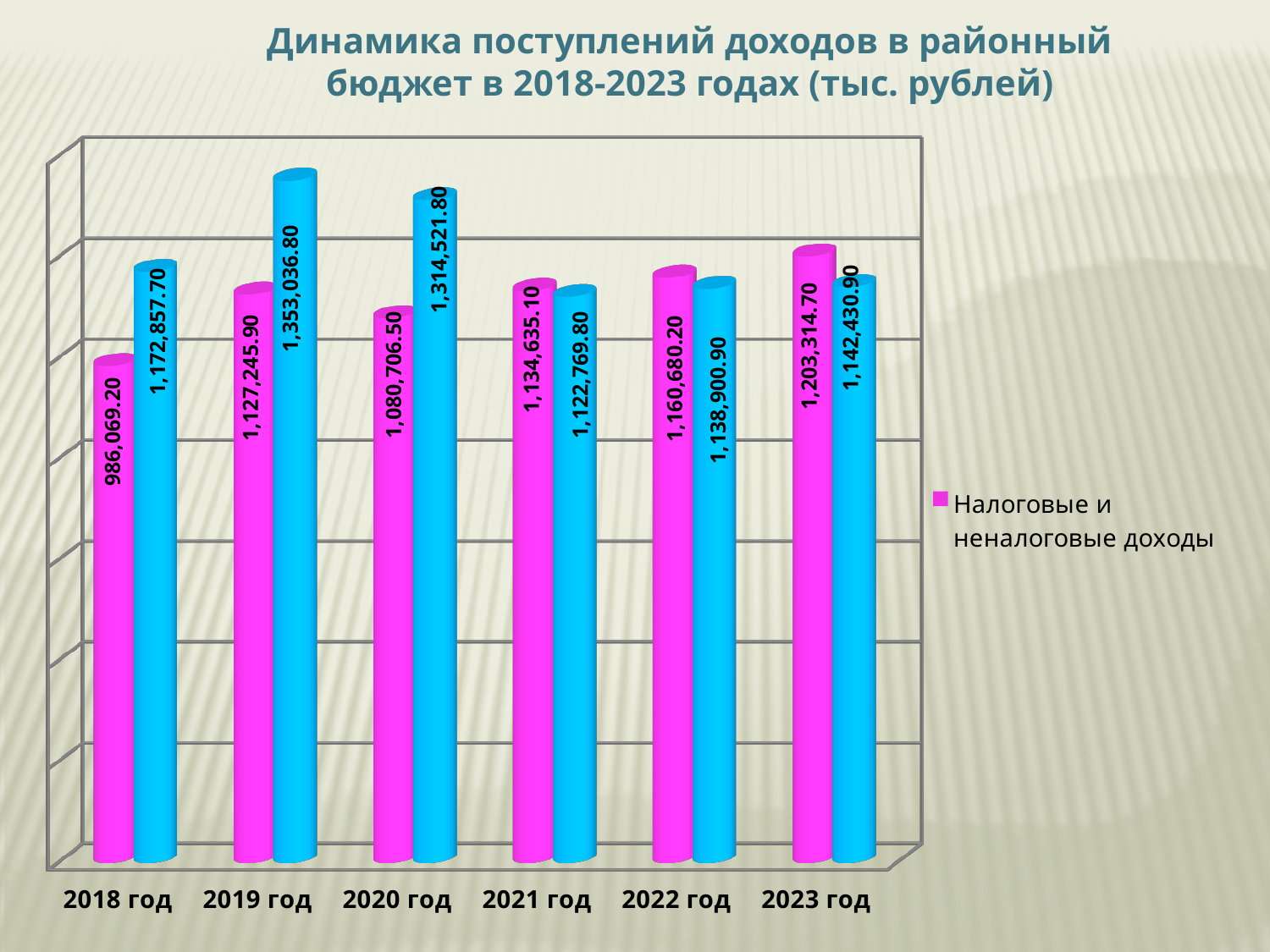
How many years are shown on the x axis? 6 What is the value of Налоговые и неналоговые доходы for 2018 год? 986,069.20 For 2021 год, which is larger: the Налоговые и неналоговые доходы bar or the blue bar? Налоговые и неналоговые доходы In which year is the value of Налоговые и неналоговые доходы the highest? 2023 год Do the values of Налоговые и неналоговые доходы rise or fall from 2021 год to 2023 год? Rise What is the value of Налоговые и неналоговые доходы for 2022 год? 1,160,680.20 What is the difference between the Налоговые и неналоговые доходы bar and the blue bar for 2023 год? 60,883.80 What value is labelled on the blue bar for 2019 год? 1,353,036.80 What is the difference between the blue bar and the Налоговые и неналоговые доходы bar for 2018 год? 186,788.50 What type of chart is shown on the slide? Bar chart In which year is the value of Налоговые и неналоговые доходы the lowest? 2018 год In which year does the blue series reach its highest value? 2019 год